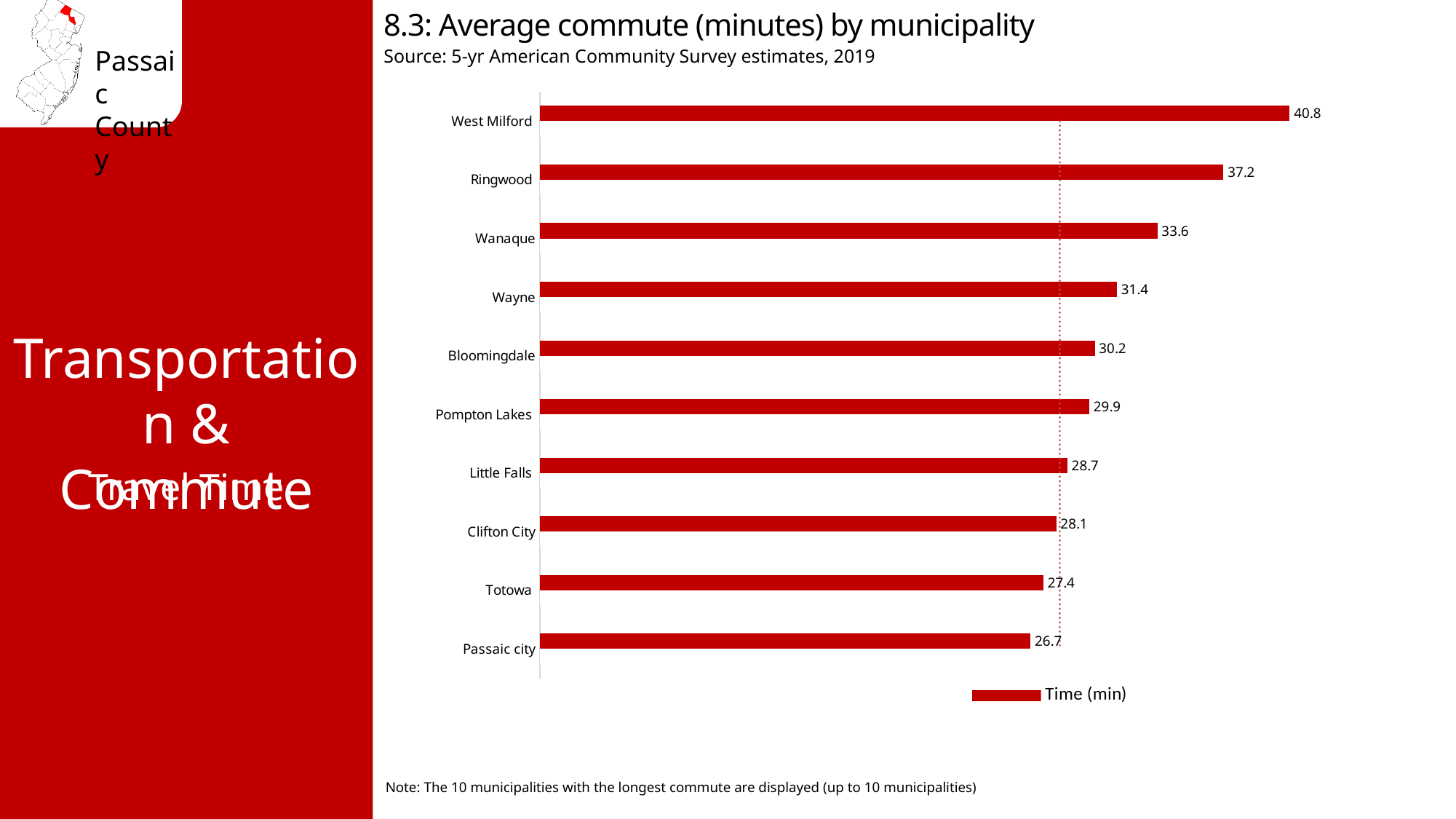
Which has a longer average commute, Bloomingdale or Little Falls? Bloomingdale What is the average commute time for Passaic city? 26.7 Which municipality has the longest average commute? West Milford What is the difference in average commute time between Wanaque and Totowa? 6.2 What is the difference in average commute time between West Milford and Ringwood? 3.6 Which municipality shown has the shortest average commute? Passaic city What is the average commute time for West Milford? 40.8 What kind of chart is shown on the slide? Bar chart What is the average commute time for Wayne? 31.4 How many series does the legend list? 1 What is the legend entry for the series in the chart? Time (min) How many municipalities are shown in the chart? 10